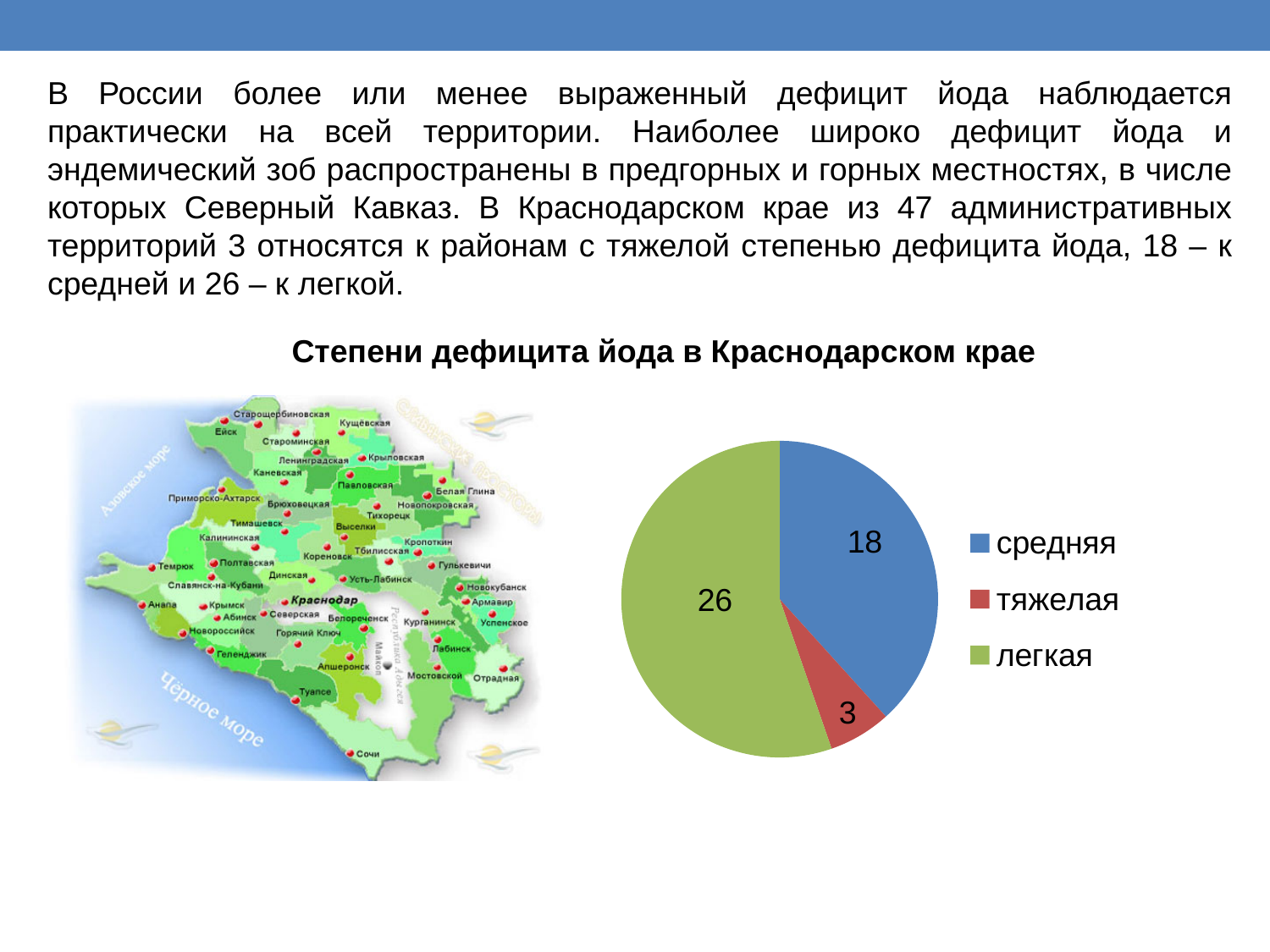
What is the total of all slices in the pie chart? 47 Which is larger, the value for средняя or the value for тяжелая? средняя What is the value for легкая? 26 What is the value for тяжелая? 3 Which category has the smallest slice? тяжелая What is the value for средняя? 18 Which category has the largest slice? легкая What is the title of the chart? Степени дефицита йода в Краснодарском крае What is the difference between the values for легкая and средняя? 8 How many entries does the legend list? 3 How many slices does the pie chart have? 3 What type of chart is shown on the slide? pie chart